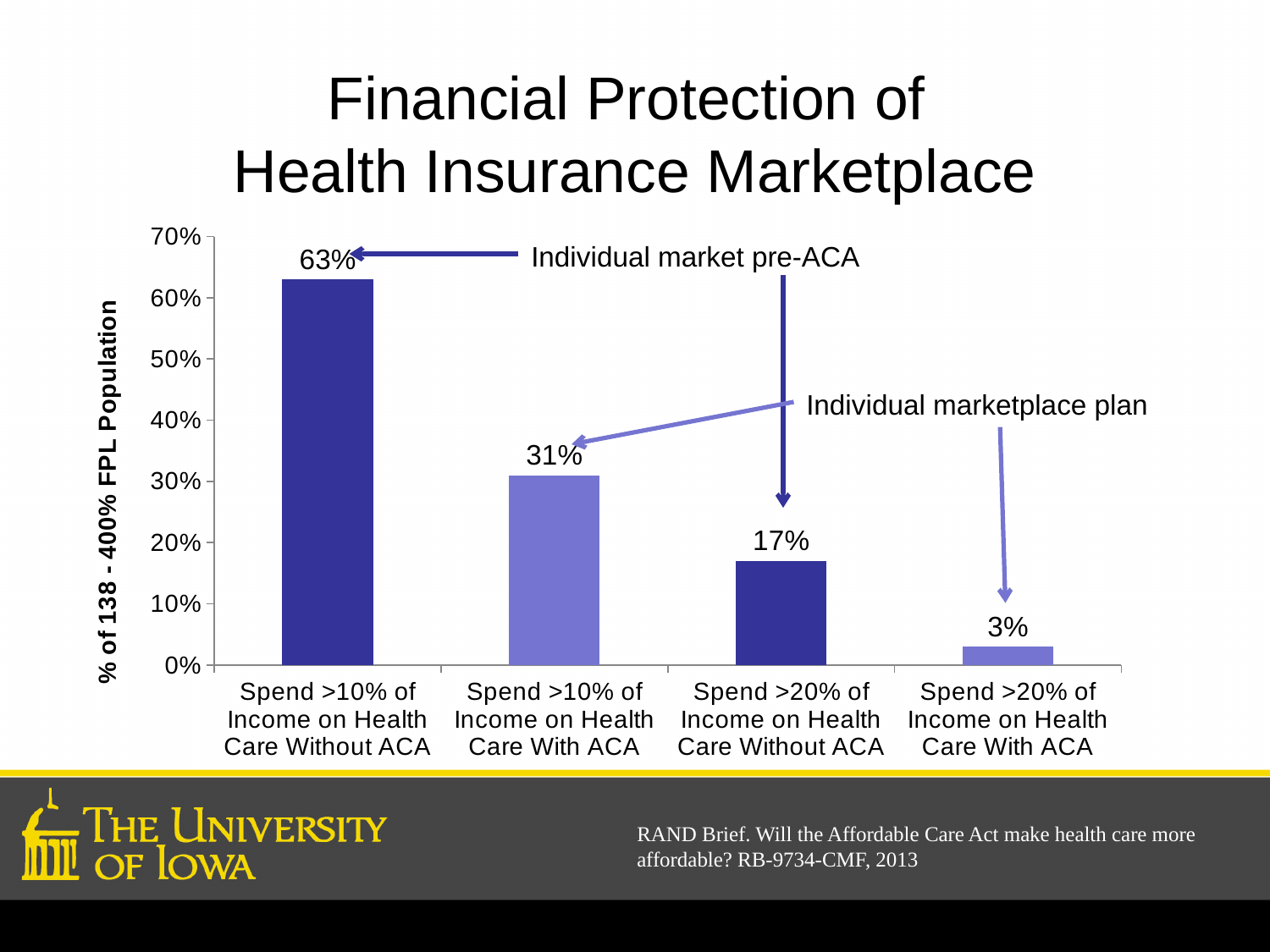
What is the value for 'Spend >20% of Income on Health Care With ACA'? 3% Which category has the lowest value? Spend >20% of Income on Health Care With ACA What is the difference between 'Spend >20% of Income on Health Care Without ACA' and 'Spend >20% of Income on Health Care With ACA'? 14% What kind of chart is shown on the slide? Bar chart Which is larger: 'Spend >10% of Income on Health Care With ACA' or 'Spend >20% of Income on Health Care Without ACA'? Spend >10% of Income on Health Care With ACA What is the label of the y axis? % of 138 - 400% FPL Population What is the difference between 'Spend >10% of Income on Health Care Without ACA' and 'Spend >10% of Income on Health Care With ACA'? 32% Which category has the highest value? Spend >10% of Income on Health Care Without ACA What is the value for 'Spend >20% of Income on Health Care Without ACA'? 17% How many categories are shown on the x axis? 4 What is the value for 'Spend >10% of Income on Health Care With ACA'? 31% What is the value for 'Spend >10% of Income on Health Care Without ACA'? 63%